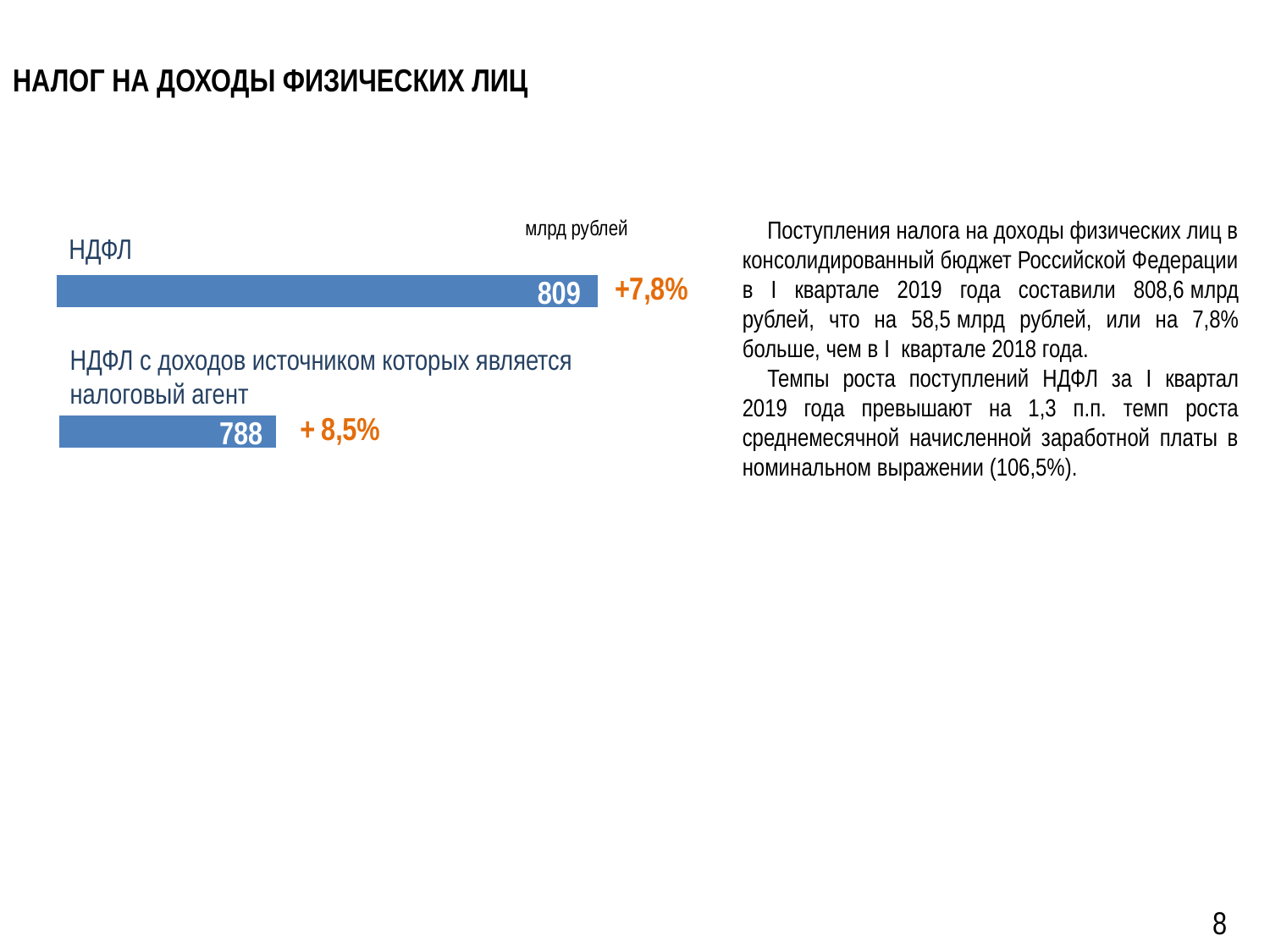
Which category has the lowest value on the chart? НДФЛ с доходов источником которых является налоговый агент What type of chart is shown on the slide? bar chart What colour are the bars on the chart? blue How many bars are shown on the chart? 2 What growth percentage is shown next to the bar for НДФЛ с доходов источником которых является налоговый агент? + 8,5% What is the value shown for НДФЛ? 809 Which category has the higher value, НДФЛ or НДФЛ с доходов источником которых является налоговый агент? НДФЛ What is the value shown for НДФЛ с доходов источником которых является налоговый агент? 788 What is the difference between the values for НДФЛ and НДФЛ с доходов источником которых является налоговый агент? 21 In what units are the chart values expressed? млрд рублей Which category shows the higher growth percentage, НДФЛ or НДФЛ с доходов источником которых является налоговый агент? НДФЛ с доходов источником которых является налоговый агент What growth percentage is shown next to the НДФЛ bar? +7,8%